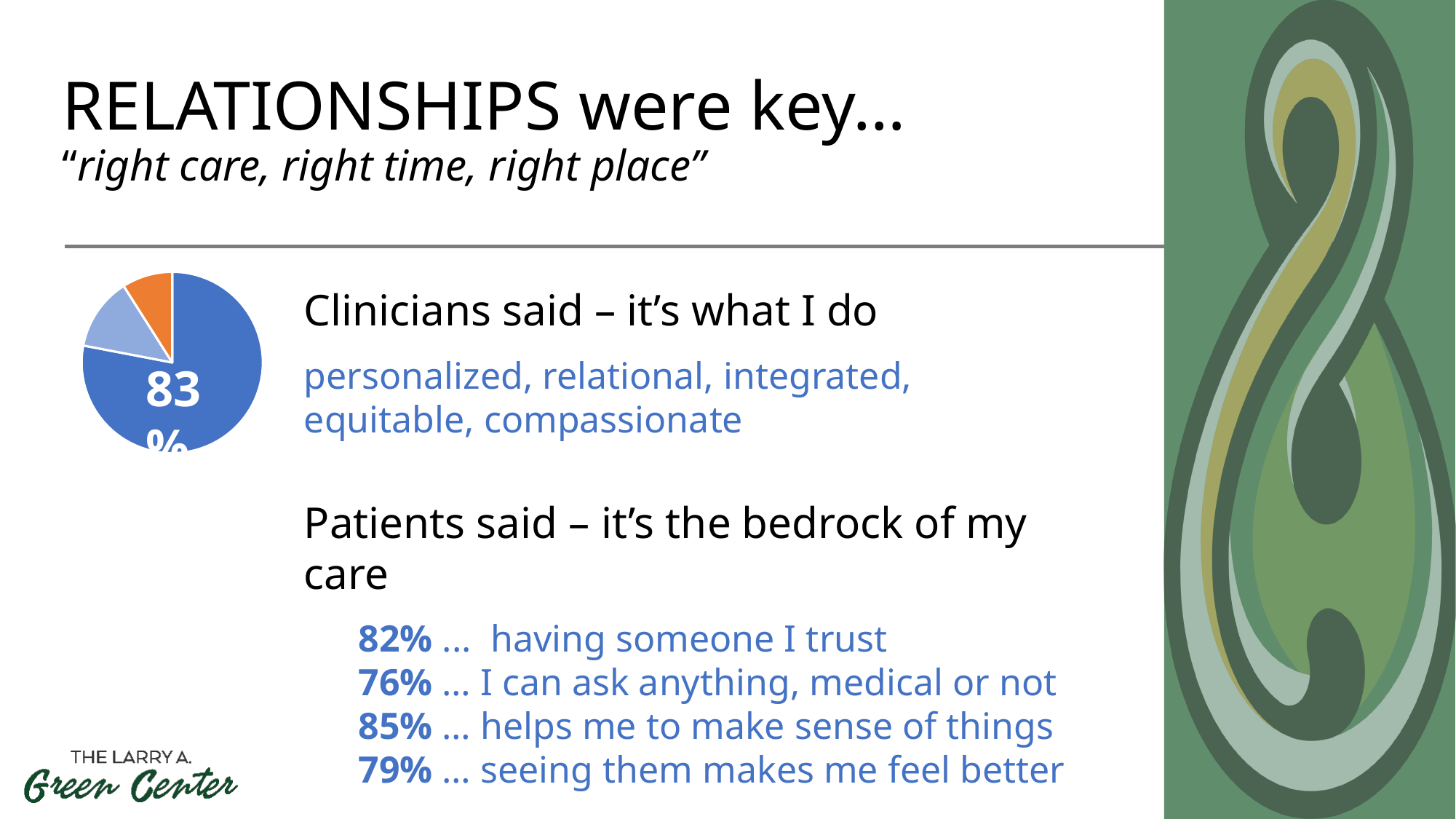
What kind of chart is shown on the left of the slide? pie chart What value is printed on the largest slice of the pie chart? 83% Which colour slice is the largest in the pie chart? dark blue Does the pie chart include a legend? No How many slices of the pie chart have a printed data label? 1 How many slices does the pie chart have? 3 In the pie chart, which is larger: the dark blue slice or the orange slice? dark blue Which colour slice is the smallest in the pie chart? orange